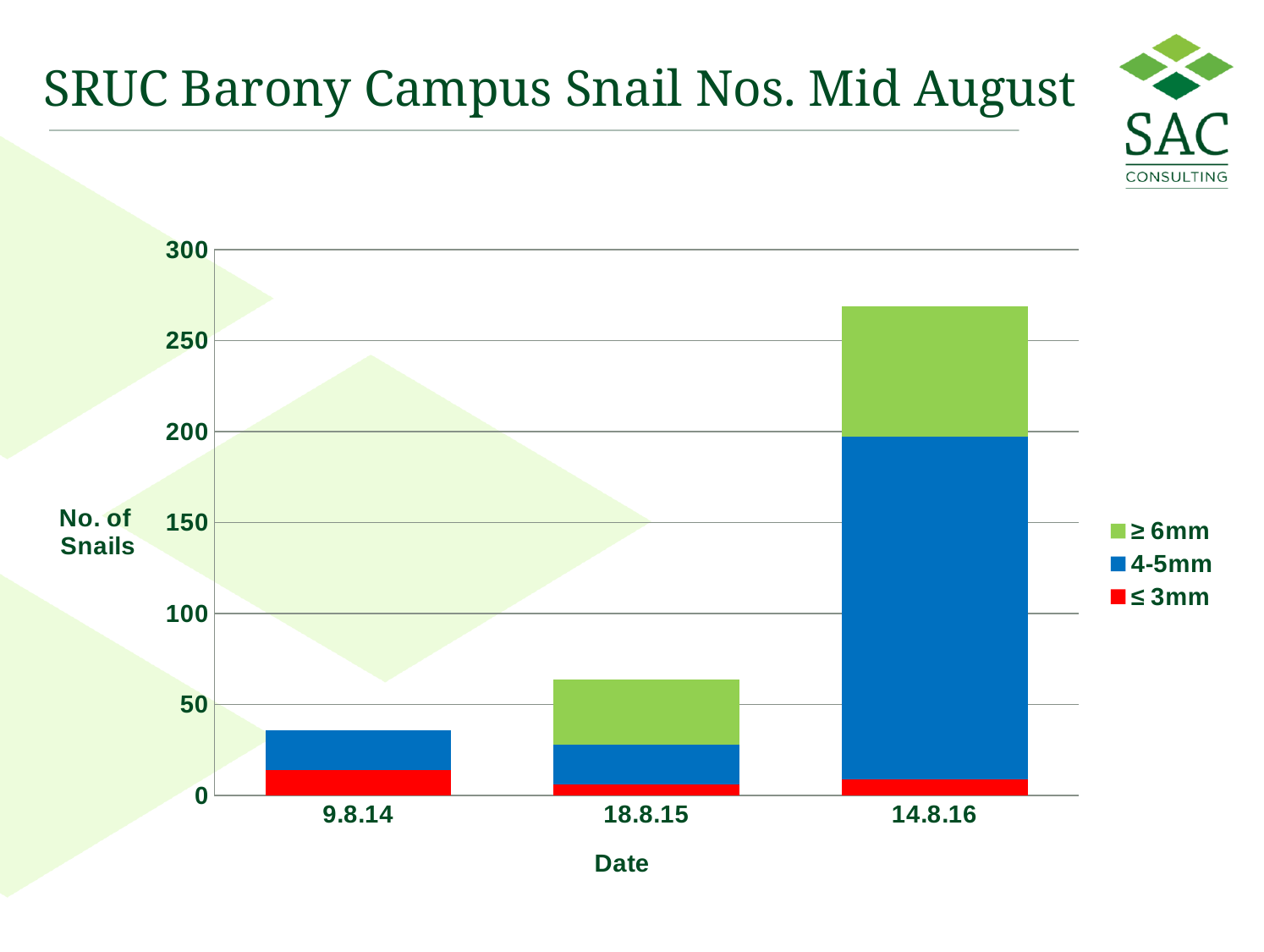
Is the total number of snails for 18.8.15 greater or less than 50? greater Do the total snail numbers rise or fall from 9.8.14 to 14.8.16? Rise Which colour represents the ≥ 6mm series in the chart? Green Which date has the highest total number of snails? 14.8.16 Which date has a larger total number of snails, 18.8.15 or 14.8.16? 14.8.16 Is the total number of snails for 14.8.16 greater or less than 250? greater Which date has the lowest total number of snails? 9.8.14 Is the total number of snails for 9.8.14 greater or less than 50? less How many series does the chart's legend list? 3 How many dates are shown on the x axis of the chart? 3 What is the title of the slide's chart? SRUC Barony Campus Snail Nos. Mid August What kind of chart is shown on the slide? Stacked bar chart